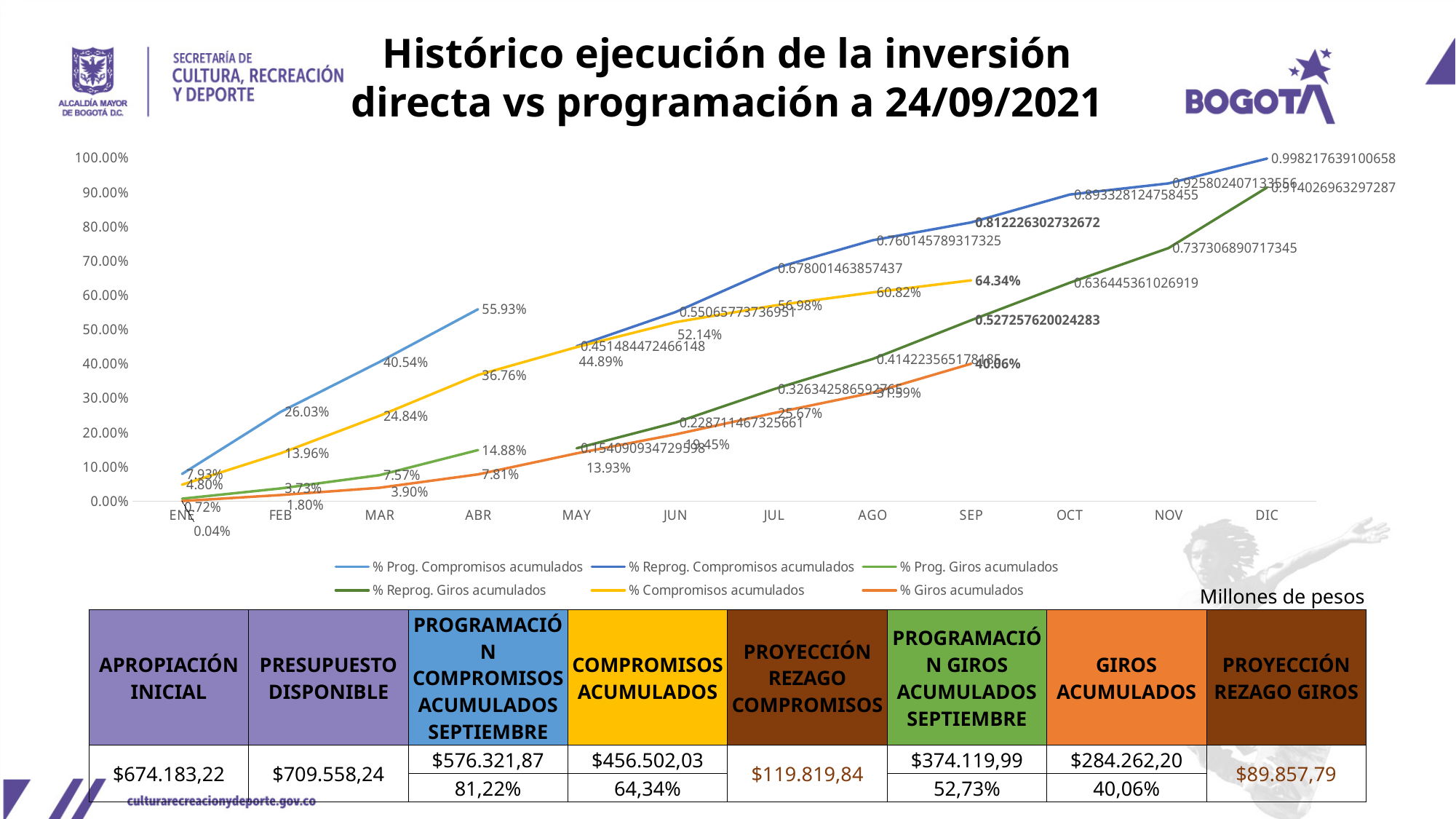
In SEP, which is larger: % Compromisos acumulados or % Giros acumulados? % Compromisos acumulados What is the value of % Compromisos acumulados in ABR? 36.76% How many series does the chart legend list? 6 How many months are shown along the x axis of the chart? 12 What is the value of % Prog. Compromisos acumulados in ABR? 55.93% Do the values of % Compromisos acumulados rise or fall from ENE to SEP? Rise What is the value of % Giros acumulados in SEP? 40.06% What type of chart is shown on the slide? Line chart What is the value of % Reprog. Compromisos acumulados in DIC? 0.998217639100658 What is the value of % Compromisos acumulados in SEP? 64.34% What is the difference between % Compromisos acumulados and % Giros acumulados in SEP? 24.28 percentage points Is the value for % Reprog. Compromisos acumulados in OCT greater or less than 80%? greater